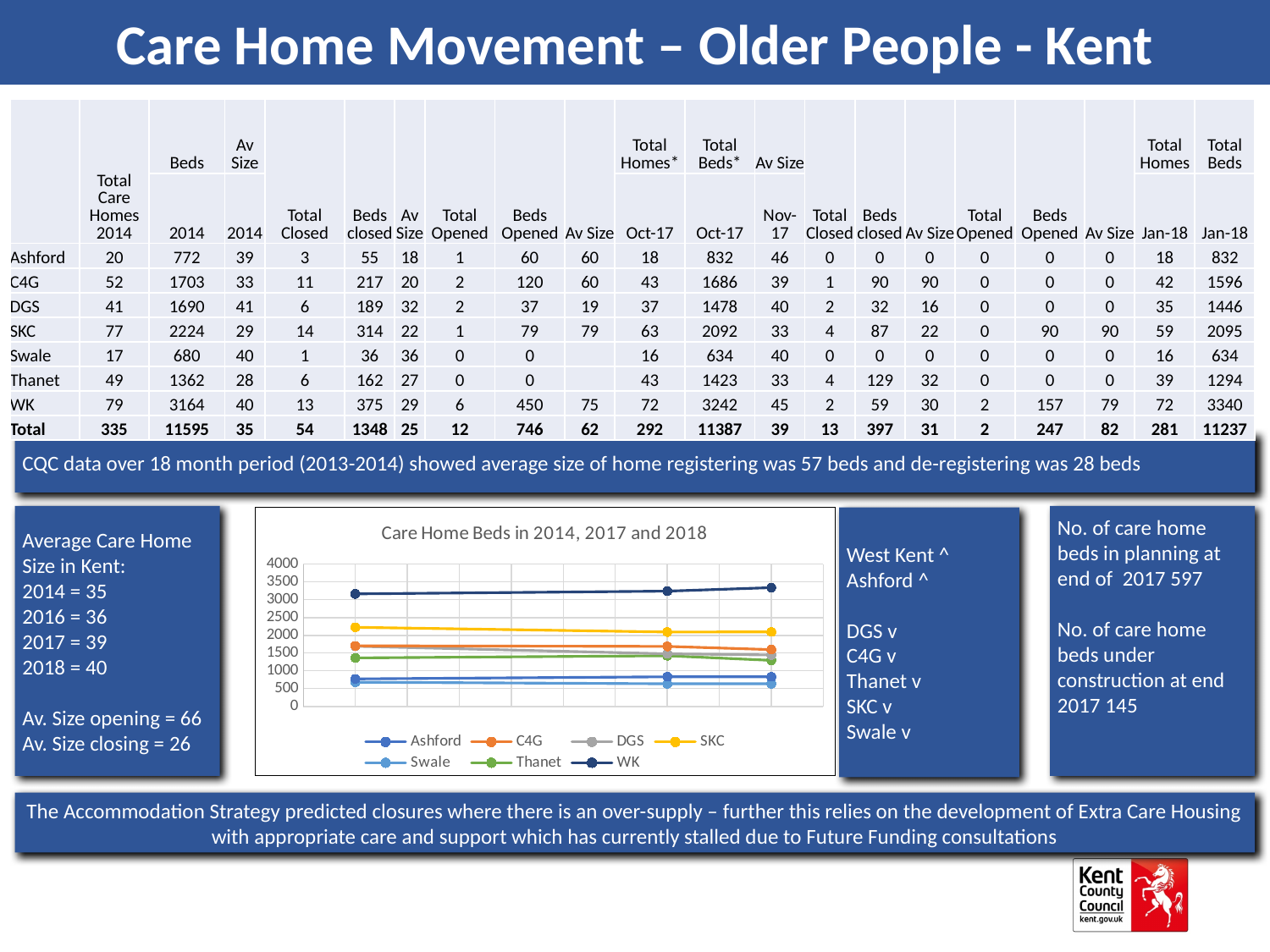
What kind of chart is shown on the slide? line chart Is the value for Swale greater or less than 1000 in the chart? less Which series has the lowest values in the chart? Swale Do the values for WK rise or fall along the x axis of the chart? rise Which series has the highest values in the chart? WK Is the value for WK greater or less than 3000 at every point in the chart? greater Is the value for Thanet greater or less than 2000 in the chart? less What is the title of the chart on the slide? Care Home Beds in 2014, 2017 and 2018 How many points are plotted for each series in the chart? 3 Which series has larger values in the chart, WK or SKC? WK How many series does the chart's legend list? 7